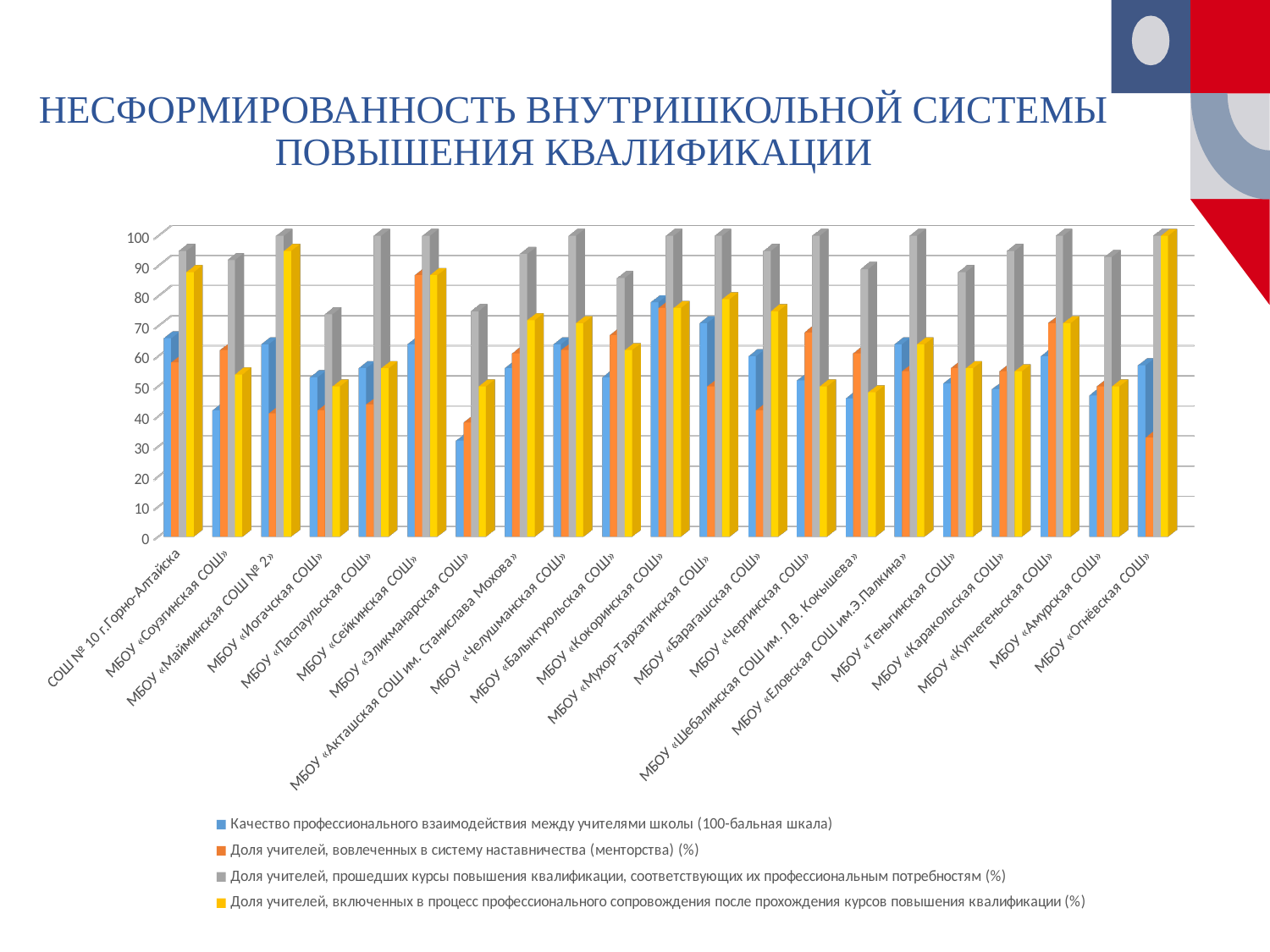
What colour represents «Доля учителей, прошедших курсы повышения квалификации, соответствующих их профессиональным потребностям (%)» in the legend? grey Is the value of «Качество профессионального взаимодействия между учителями школы» for МБОУ «Кокоринская СОШ» greater or less than 70? greater How many series does the legend list? 4 Which school has the lowest value for «Качество профессионального взаимодействия между учителями школы (100-бальная шкала)»? МБОУ «Эликманарская СОШ» Which school has the highest value for «Доля учителей, вовлеченных в систему наставничества (менторства) (%)»? МБОУ «Сейкинская СОШ» How many schools (categories) are shown on the x axis? 21 Is the value of «Доля учителей, вовлеченных в систему наставничества (менторства) (%)» for МБОУ «Сейкинская СОШ» greater or less than 80? greater Is the value of «Качество профессионального взаимодействия между учителями школы» for МБОУ «Акташская СОШ им. Станислава Мохова» greater or less than 40? greater What kind of chart is shown on the slide? bar chart Which school has the larger value for «Качество профессионального взаимодействия между учителями школы»: МБОУ «Кокоринская СОШ» or МБОУ «Акташская СОШ им. Станислава Мохова»? МБОУ «Кокоринская СОШ» For МБОУ «Сейкинская СОШ», which is larger: «Качество профессионального взаимодействия между учителями школы» or «Доля учителей, вовлеченных в систему наставничества (менторства) (%)»? Доля учителей, вовлеченных в систему наставничества (менторства) (%)